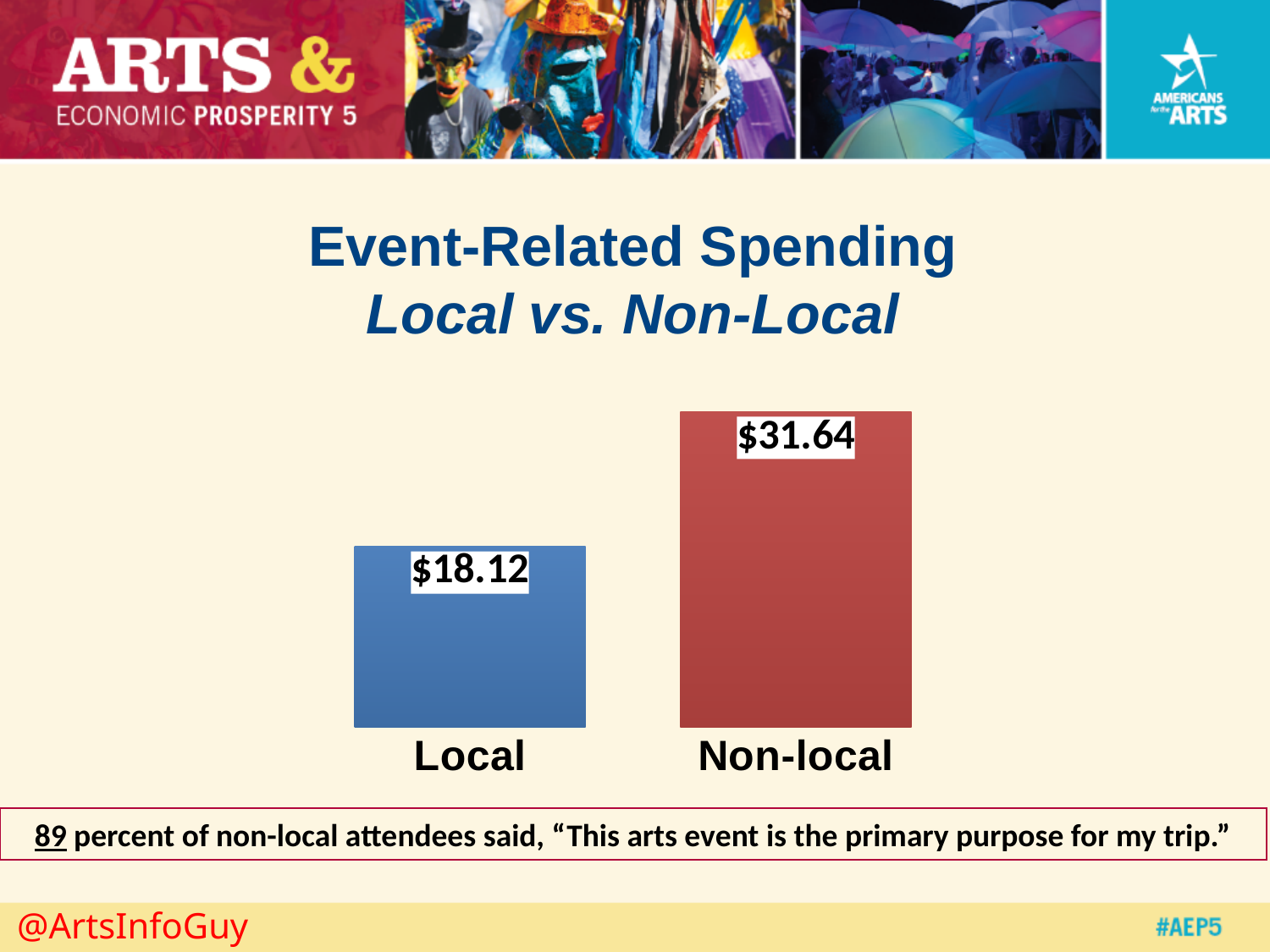
What is the event-related spending value for Local attendees? $18.12 Which category has the higher event-related spending? Non-local What is the title of the chart? Event-Related Spending Local vs. Non-Local How many categories are shown in the chart? 2 What colour is the bar for Non-local attendees? red Which category has the lower event-related spending? Local What kind of chart is shown on the slide? bar chart Is the spending for Local attendees larger or smaller than the spending for Non-local attendees? smaller What is the event-related spending value for Non-local attendees? $31.64 What is the difference in spending between Non-local and Local attendees? $13.52